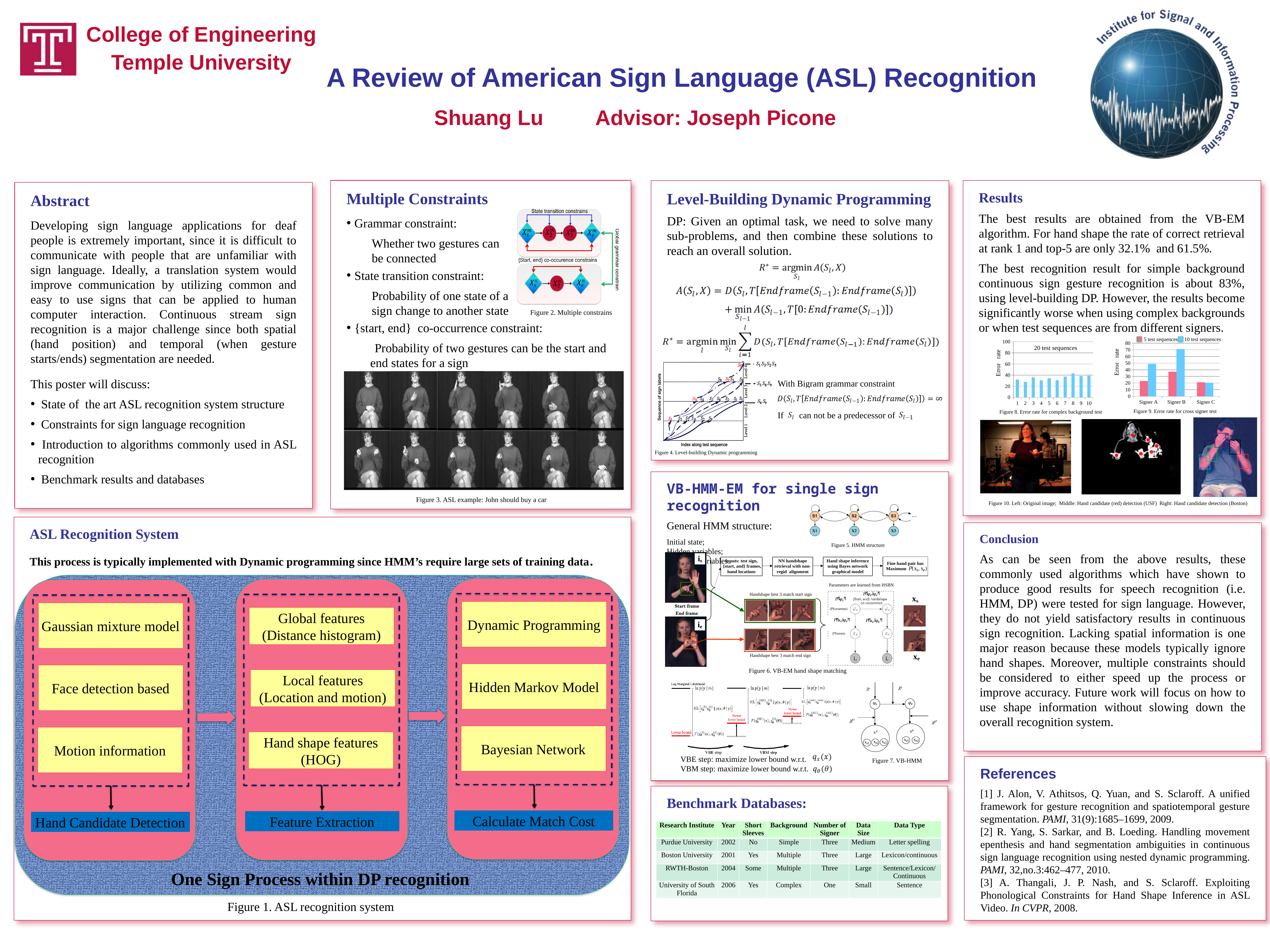
In Figure 8 (Error rate for complex background test), is the error rate for test sequence 1 greater or less than 60? less In Figure 9 (Error rate for cross signer test), how many series does the legend list? 2 In Figure 8 (Error rate for complex background test), what kind of chart is shown? bar chart In Figure 8 (Error rate for complex background test), how many test sequence bars are plotted along the x axis? 10 In Figure 9 (Error rate for cross signer test), is the 5 test sequences error rate for Signer B greater or less than 30? greater In Figure 9 (Error rate for cross signer test), what kind of chart is shown? bar chart In Figure 8 (Error rate for complex background test), what is the label on the y axis? Error rate In Figure 9 (Error rate for cross signer test), is the 5 test sequences error rate for Signer A greater or less than 40? less In Figure 9 (Error rate for cross signer test), for Signer A, which series has the larger error rate: 5 test sequences or 10 test sequences? 10 test sequences In Figure 9 (Error rate for cross signer test), what are the two legend entries? 5 test sequences, 10 test sequences In Figure 9 (Error rate for cross signer test), which signer has the highest error rate for the 10 test sequences series? Signer B